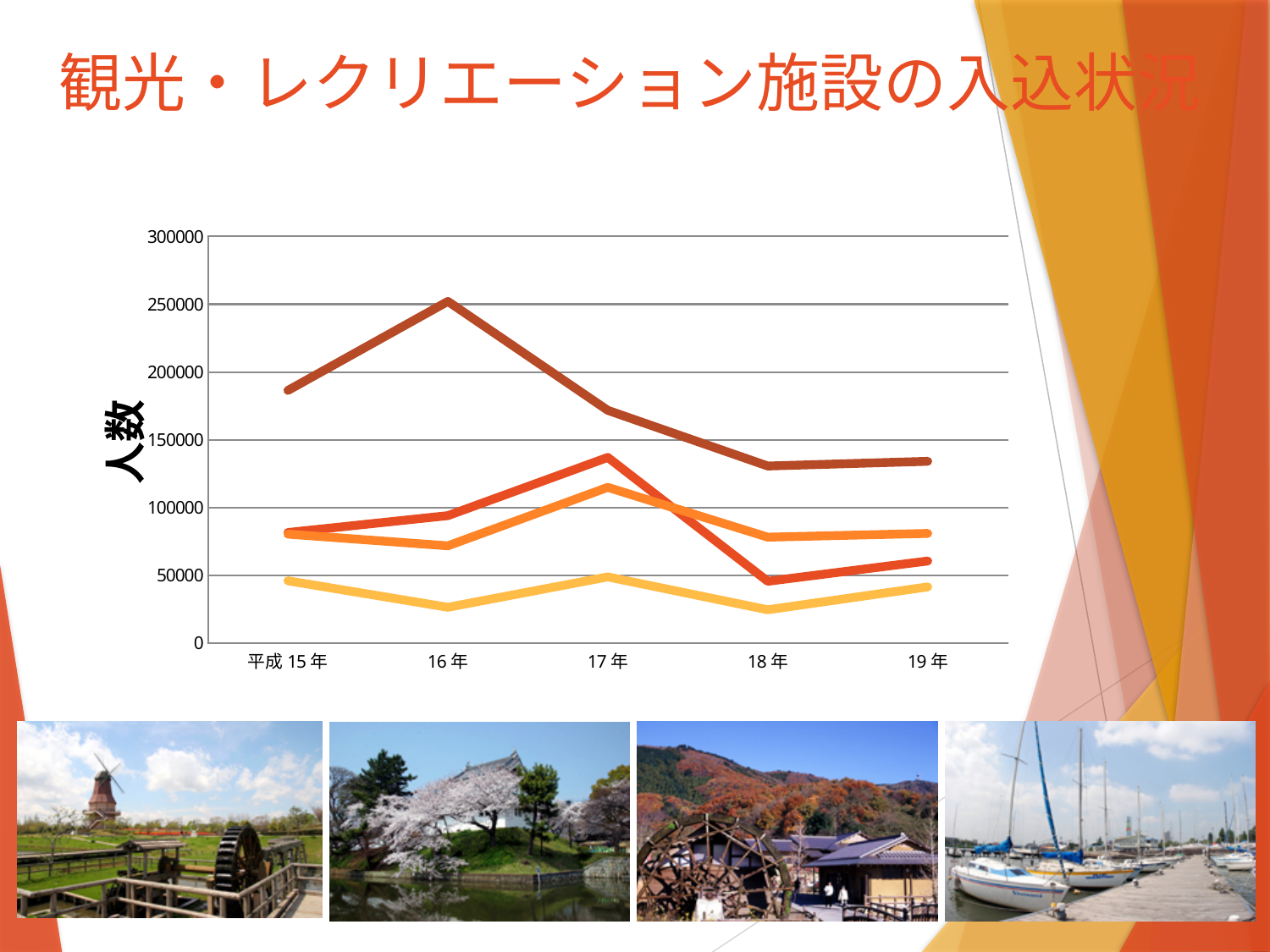
How many years are shown along the x axis of the chart? 5 How many lines are plotted on the chart? 4 What is the label on the vertical axis of the chart? 人数 Is the value of the orange line (second from the bottom at 19年) at 18年 greater or less than 100000? less In which year does the dark brown (topmost) line reach its highest value? 16年 At 17年, which line is higher: the red-orange line or the orange line? the red-orange line Is the value of the yellow (lowest) line at 16年 greater or less than 50000? less Is the value of the dark brown (topmost) line at 平成15年 greater or less than 150000? greater What kind of chart is shown on the slide? line chart What is the title of the slide containing the chart? 観光・レクリエーション施設の入込状況 Does the dark brown (topmost) line rise or fall from 16年 to 18年? fall